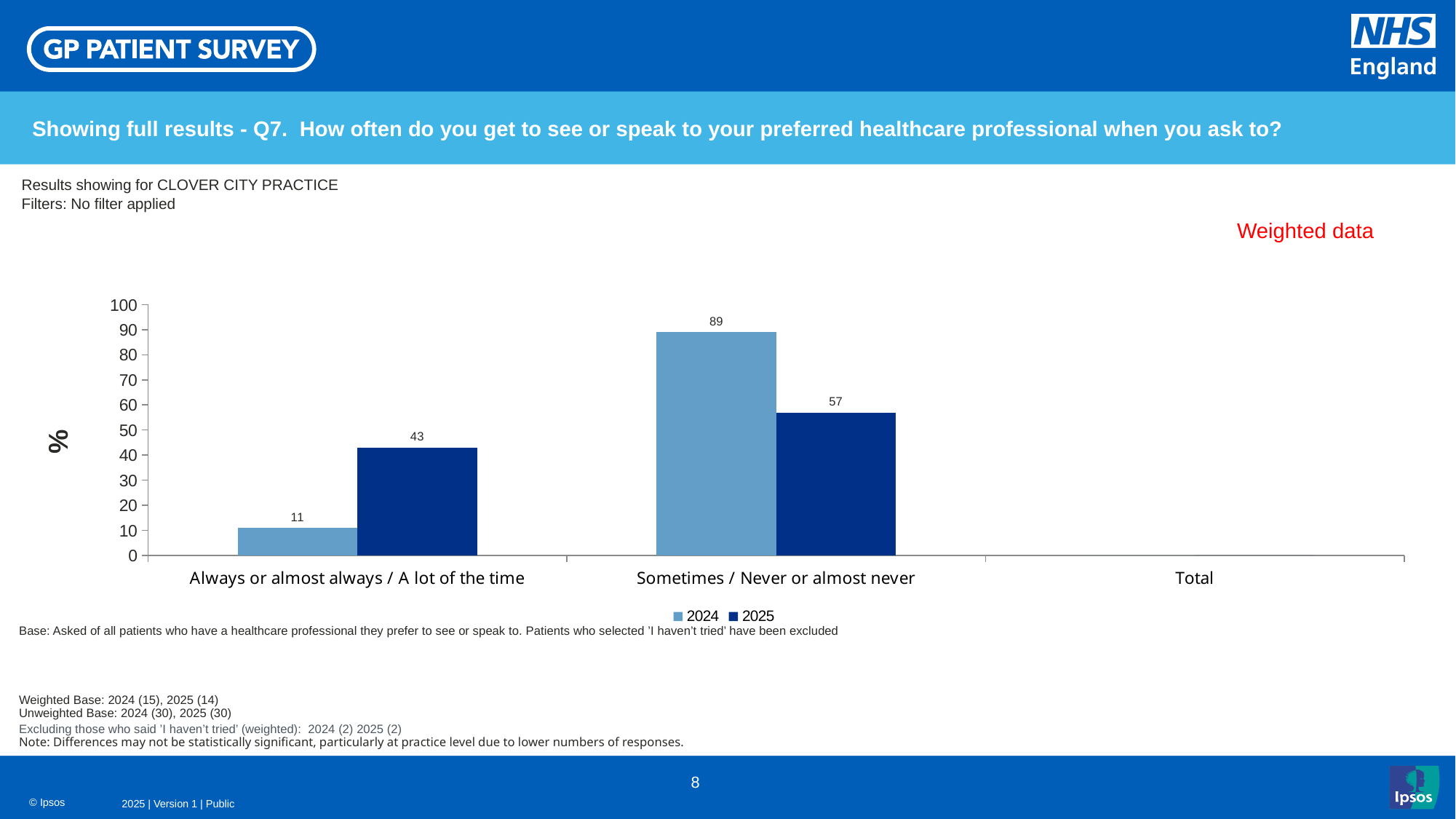
What is the 2024 value for 'Always or almost always / A lot of the time'? 11 What kind of chart is shown on the slide? Bar chart Which category has the highest 2024 value? Sometimes / Never or almost never How many series does the legend list? 2 Which category has the lowest 2025 value? Always or almost always / A lot of the time What is the 2024 value for 'Sometimes / Never or almost never'? 89 What is the label on the vertical axis of the chart? % What is the 2025 value for 'Always or almost always / A lot of the time'? 43 What is the 2025 value for 'Sometimes / Never or almost never'? 57 What is the difference between the 2024 and 2025 values for 'Sometimes / Never or almost never'? 32 Which is larger for 'Always or almost always / A lot of the time': the 2024 value or the 2025 value? 2025 Is the 2025 value for 'Sometimes / Never or almost never' greater or less than 50? greater